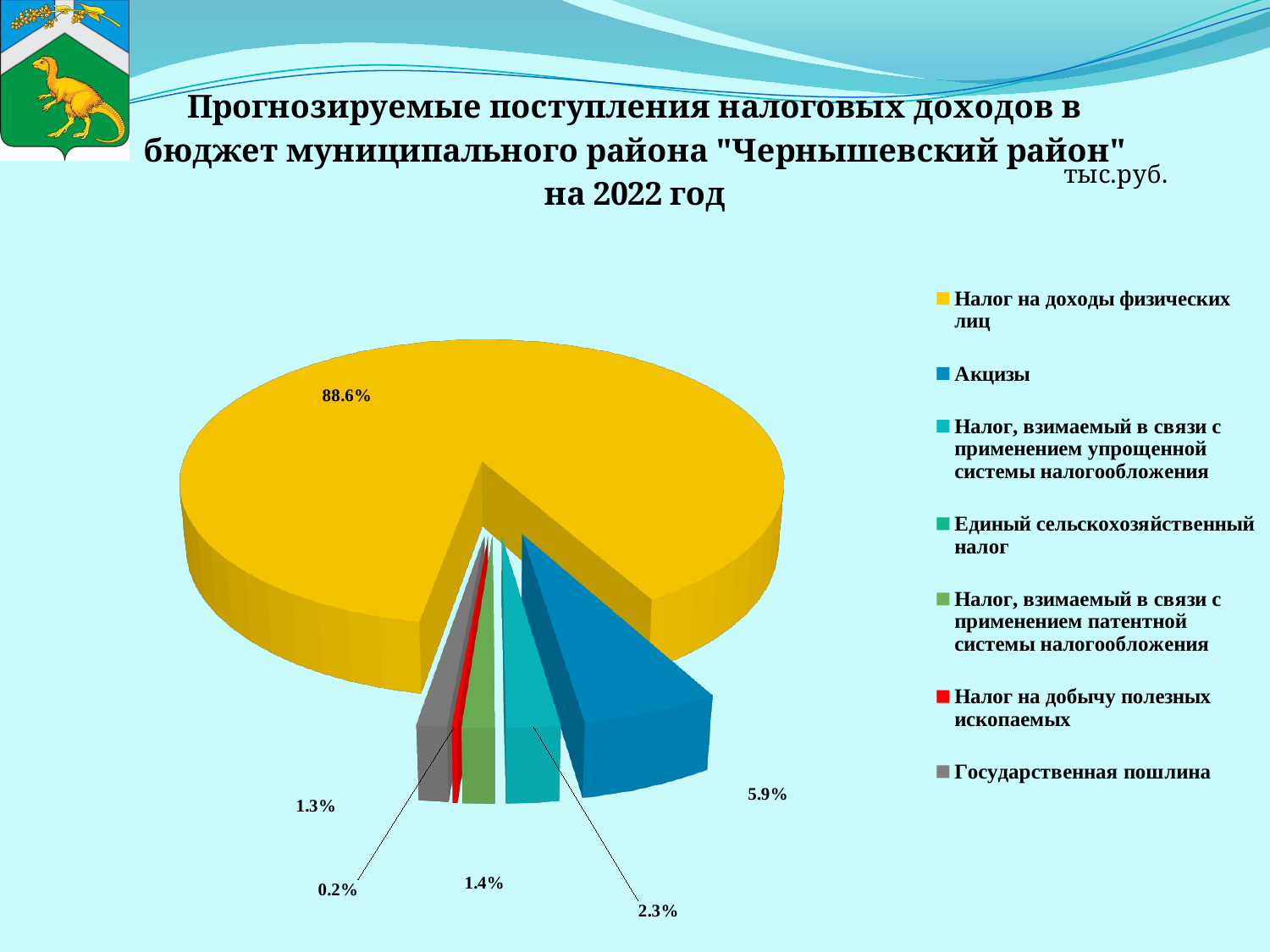
What kind of chart is shown on the slide? pie chart What share of the forecast tax revenues does "Налог на доходы физических лиц" account for? 88.6% By how many percentage points does the share of "Налог на доходы физических лиц" exceed the share of "Акцизы"? 82.7 Which category has the largest slice of the pie? Налог на доходы физических лиц What unit is indicated in the top right of the slide? тыс.руб. What colour is the slice for "Налог на доходы физических лиц"? yellow What share of the pie is labelled for "Акцизы"? 5.9% What percentage is shown for "Налог на добычу полезных ископаемых"? 0.2% Which is larger: the share for "Акцизы" or the share for "Налог, взимаемый в связи с применением упрощенной системы налогообложения"? Акцизы How many categories does the legend list? 7